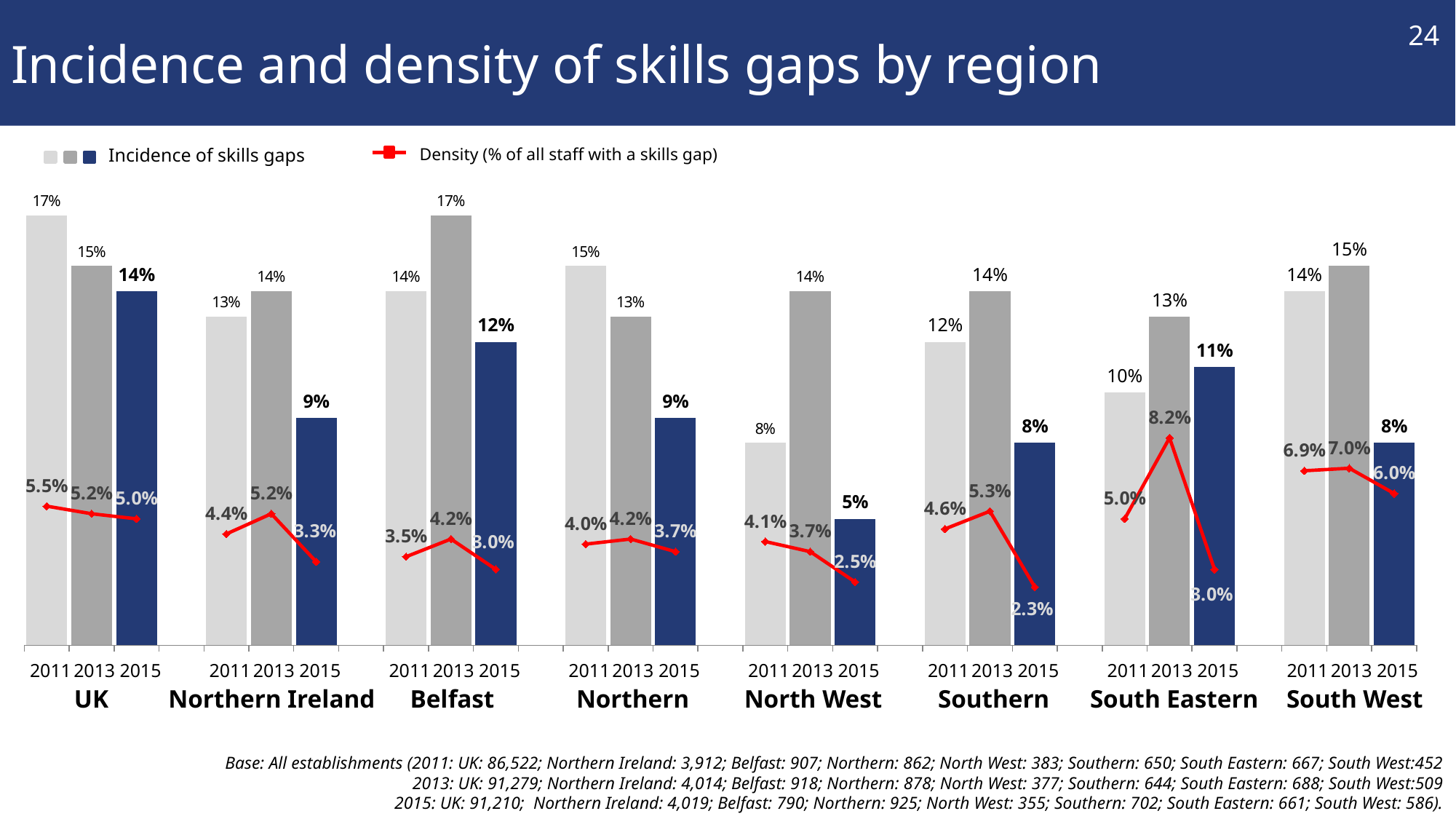
What was the incidence of skills gaps in Belfast in 2015? 12% What does the red line on the chart represent? Density (% of all staff with a skills gap) What type of chart is used on this slide? A combined bar and line chart Which region had the highest incidence of skills gaps in 2013? Belfast What was the incidence of skills gaps in North West in 2011? 8% Which was higher in 2015: the incidence of skills gaps in South Eastern or in Northern Ireland? South Eastern What was the density of skills gaps (% of all staff with a skills gap) in South Eastern in 2013? 8.2% By how many percentage points did the incidence of skills gaps in the UK fall between 2011 and 2015? 3 percentage points How many regions (including the UK) are shown on the chart? 8 Which region had the lowest density of skills gaps in 2015? Southern What is the difference between the 2013 and 2015 density of skills gaps in South Eastern? 5.2 percentage points How did the density of skills gaps in Southern change from 2013 to 2015? It fell from 5.3% to 2.3%